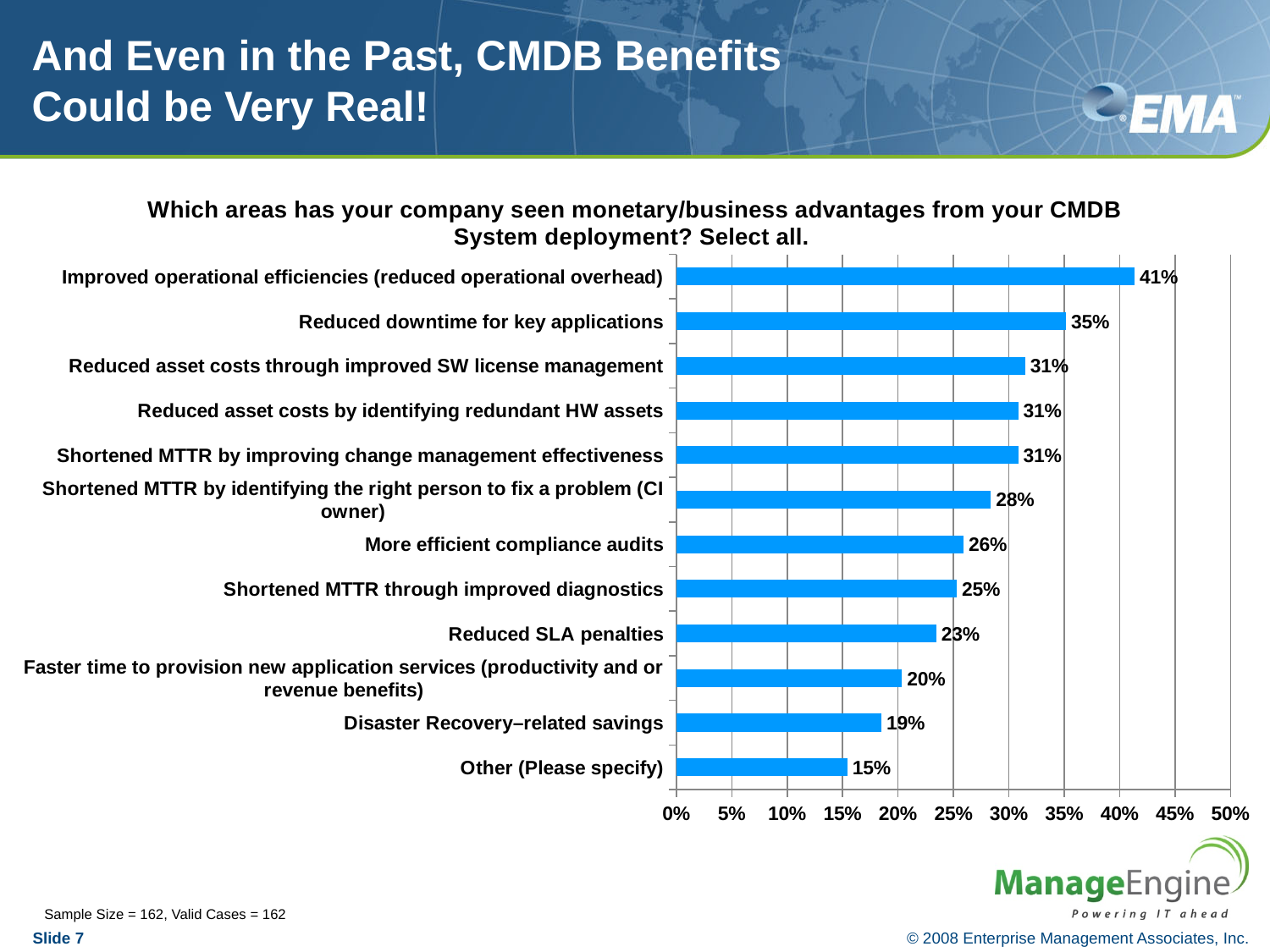
Which area has the highest percentage? Improved operational efficiencies (reduced operational overhead) Which area has the lowest percentage? Other (Please specify) What is the sample size noted on the slide? 162 How many areas (categories) are shown in the chart? 12 Is the value for Shortened MTTR through improved diagnostics greater or less than 30%? less What is the difference between Improved operational efficiencies and Reduced downtime for key applications? 6% What percentage is shown for Disaster Recovery–related savings? 19% What type of chart is shown on the slide? Bar chart Which is larger: More efficient compliance audits or Reduced SLA penalties? More efficient compliance audits What is the value for Reduced downtime for key applications? 35% How many areas share the value of 31%? 3 What percentage of respondents reported improved operational efficiencies (reduced operational overhead)? 41%